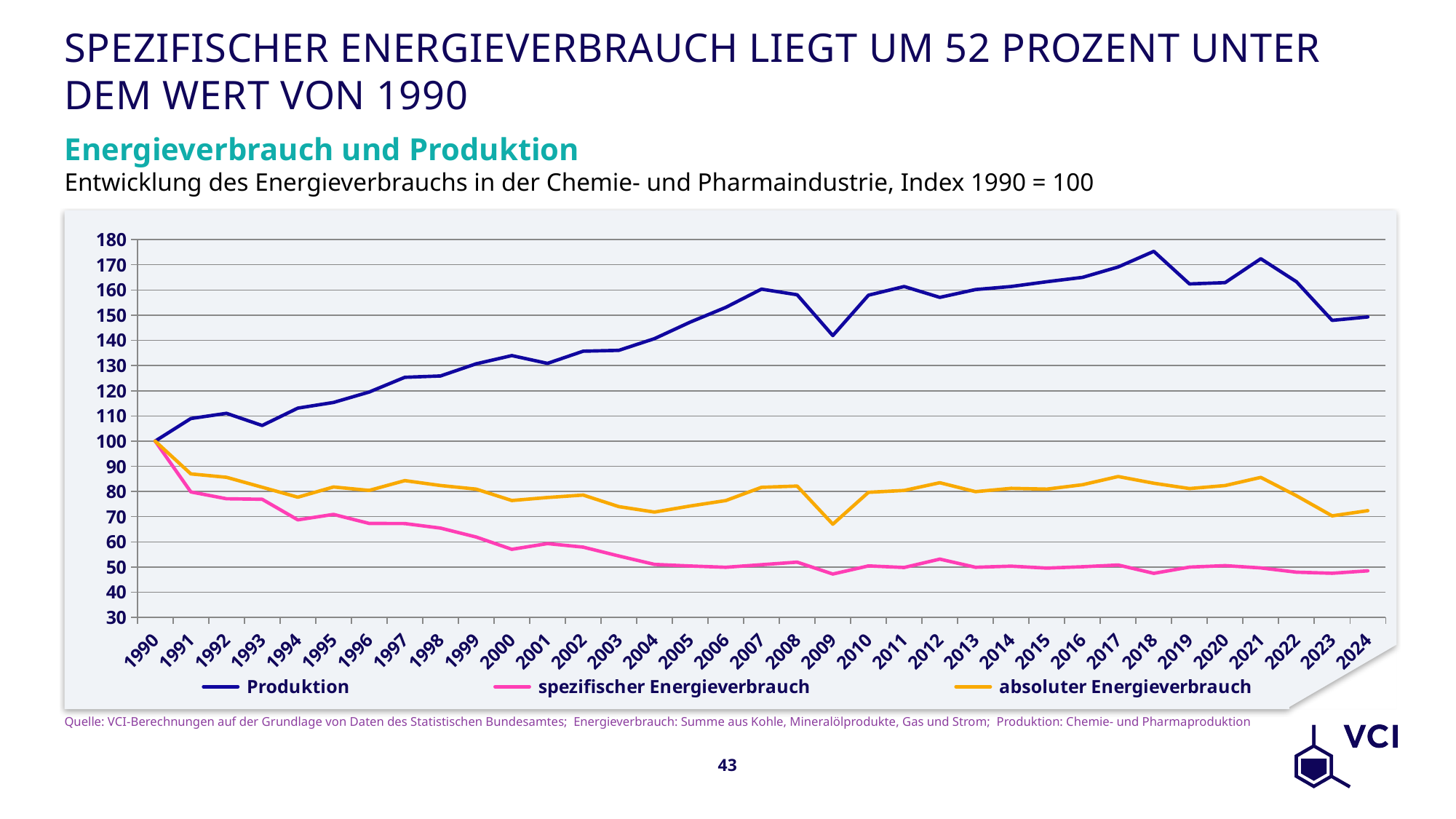
Which series has the lowest value in 2024? spezifischer Energieverbrauch What is the value of Produktion in 1990? 100 What kind of chart is shown on the slide? line chart Is the value for spezifischer Energieverbrauch in 2024 greater or less than 60? less How many series does the legend list? 3 How many years are plotted along the x axis? 35 Is the value for absoluter Energieverbrauch in 2017 greater or less than 80? greater Does the spezifischer Energieverbrauch line rise or fall from 1990 to 2024? fall Is the value for Produktion in 2018 greater or less than 170? greater Which series has the highest value in 2024? Produktion Which is larger for Produktion: the value in 2021 or the value in 2023? 2021